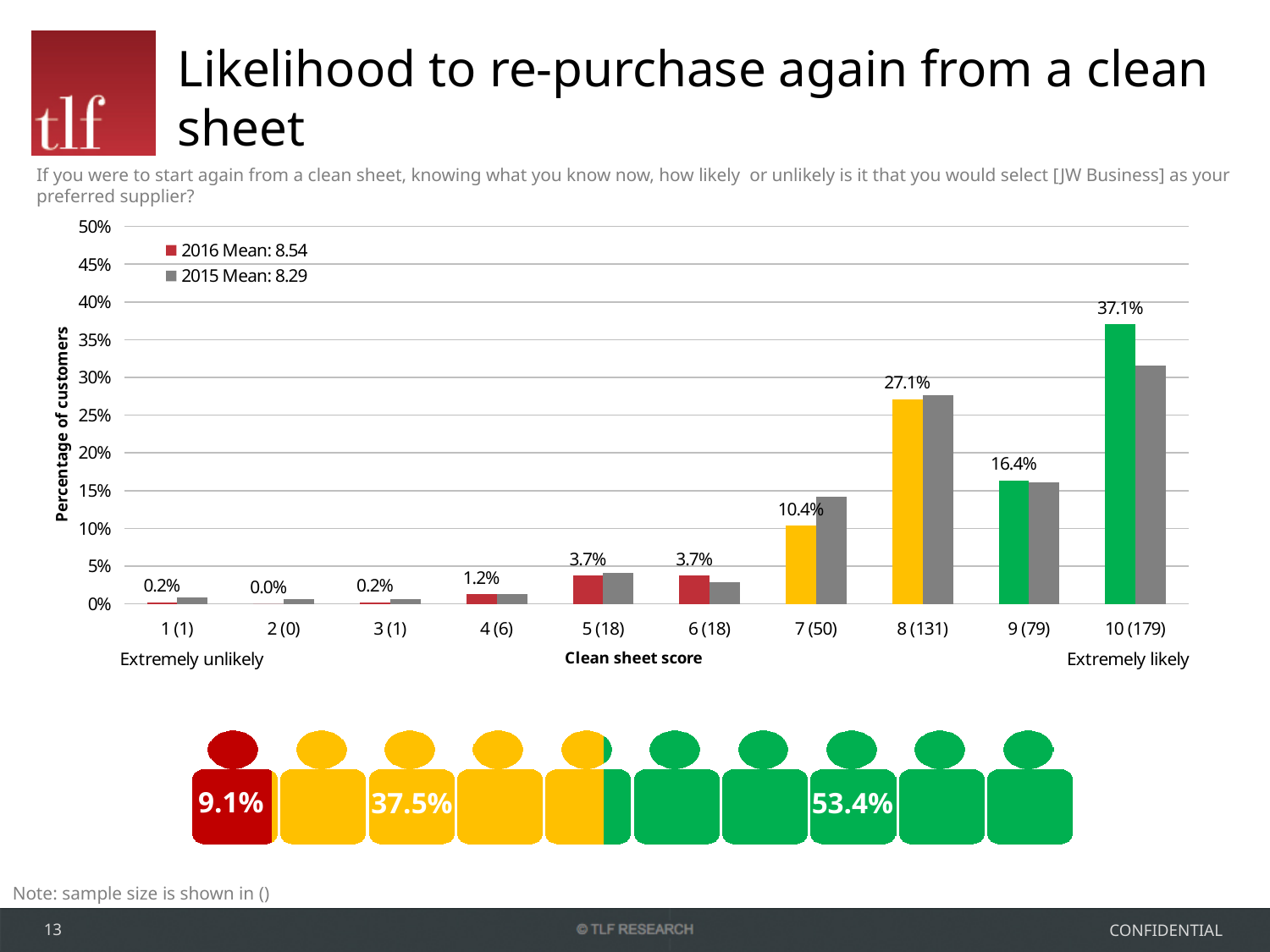
What is the 2016 value for clean sheet score 7 (50)? 10.4% Which clean sheet score has the highest 2016 percentage of customers? 10 (179) How many clean sheet score categories are shown on the x axis? 10 How many series does the legend list? 2 What is the 2016 value for clean sheet score 8 (131)? 27.1% What is the difference between the 2016 values for score 10 (179) and score 8 (131)? 10.0% What kind of chart is shown on the slide? Bar chart Which clean sheet score has the lowest 2016 percentage of customers? 2 (0) Which is larger for 2016: the value for score 8 (131) or score 9 (79)? 8 (131) Is the 2015 value for clean sheet score 10 (179) greater or less than 30%? greater What is the 2016 mean shown in the legend? 8.54 What is the 2016 value for clean sheet score 10 (179)? 37.1%